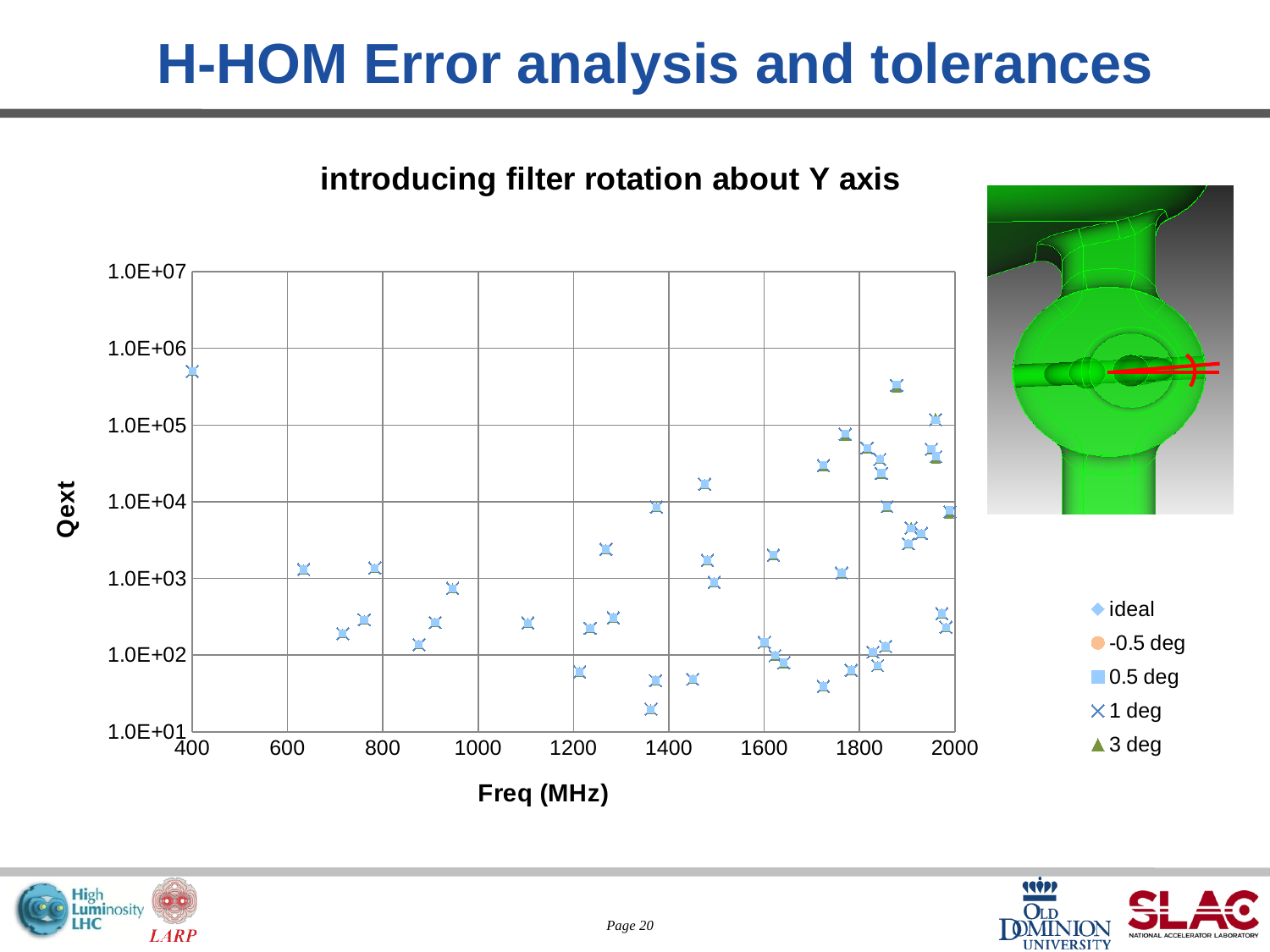
Is the Qext value of the point near 640 MHz greater or less than 1.0E+03? greater Is the Qext value of the lowest point on the chart, near 1360 MHz, greater or less than 1.0E+02? less Is the Qext value of the highest point near 1880 MHz greater or less than 1.0E+05? greater What is the label of the chart's x axis? Freq (MHz) What is the lowest value shown on the chart's y axis? 1.0E+01 What is the title of the chart? introducing filter rotation about Y axis How many series does the chart legend list? 5 What kind of chart is shown on the slide? scatter chart